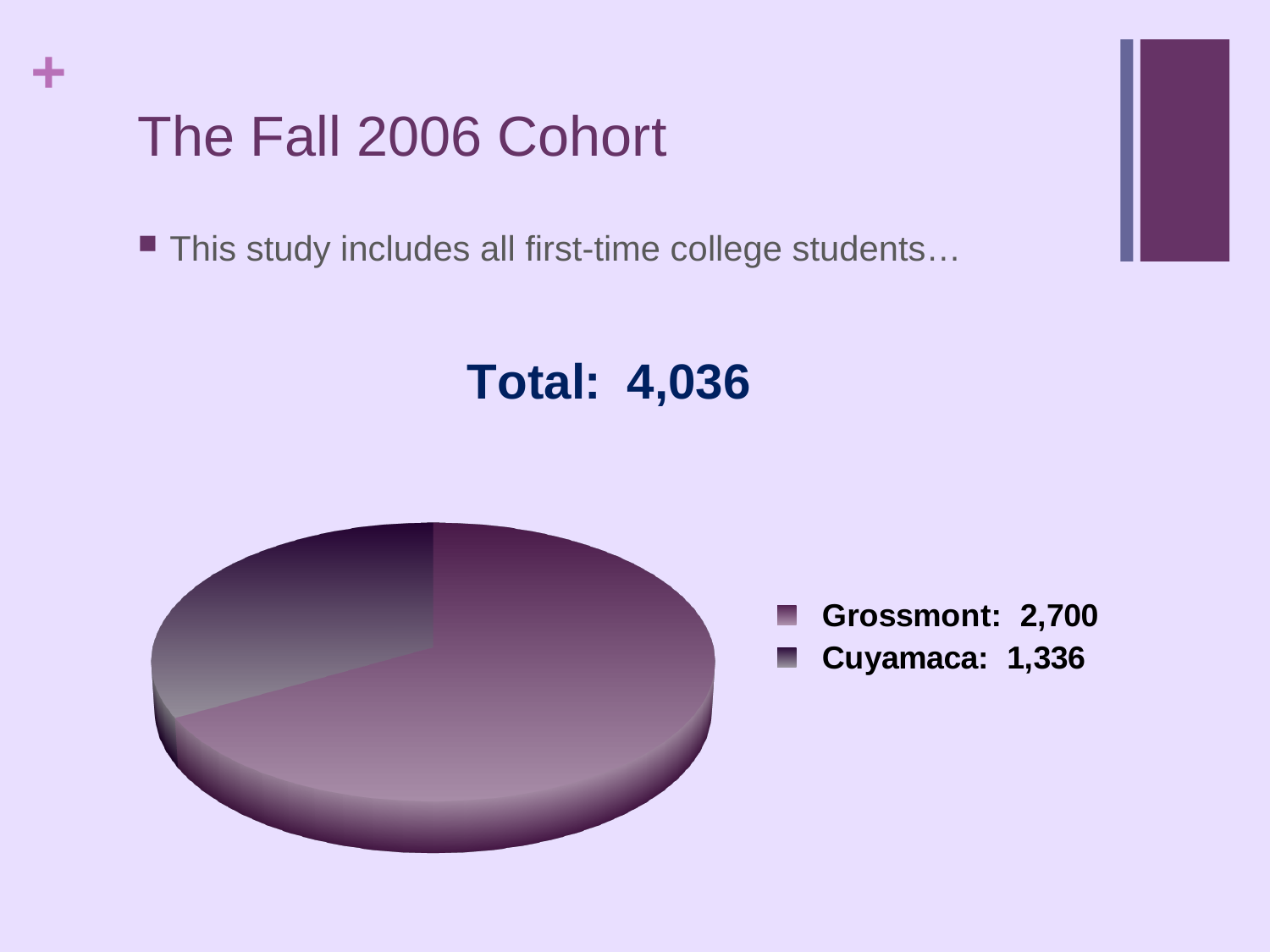
What share of the total does Grossmont represent? 66.9% What total is shown above the pie chart? 4,036 What is the difference between the Grossmont and Cuyamaca values? 1,364 What is the value for Cuyamaca in the pie chart? 1,336 Which college has the larger slice in the pie chart? Grossmont What is the title of the slide containing the pie chart? The Fall 2006 Cohort How many slices does the pie chart have? 2 Which college has the smaller slice in the pie chart? Cuyamaca What is the value for Grossmont in the pie chart? 2,700 What kind of chart is shown on the slide? pie chart How many entries does the legend list? 2 Is the value for Grossmont larger or smaller than the value for Cuyamaca? larger